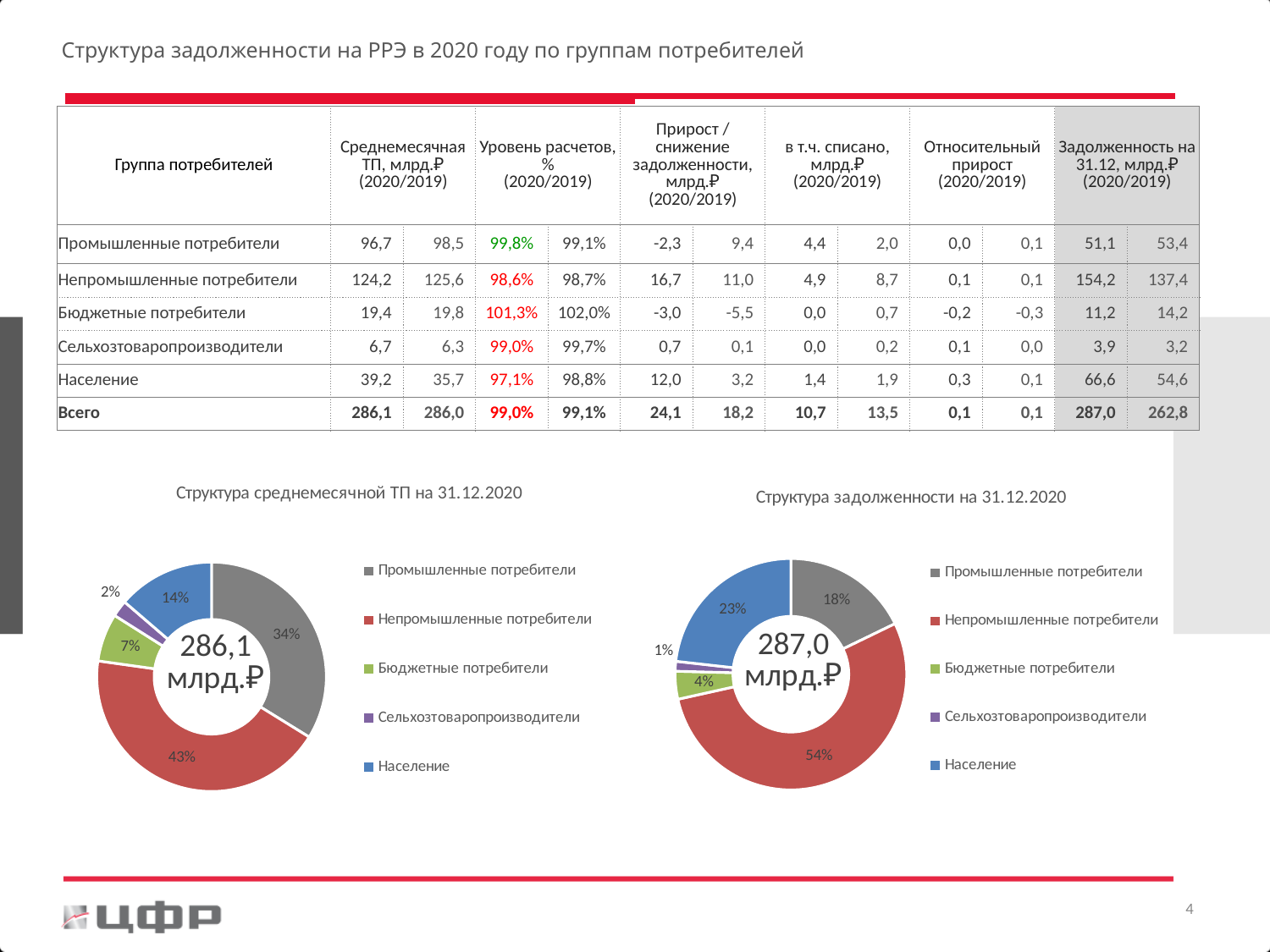
In the chart 'Структура среднемесячной ТП на 31.12.2020', what share do Промышленные потребители have? 34% In the chart 'Структура среднемесячной ТП на 31.12.2020', which colour represents Население? Blue In the chart 'Структура задолженности на 31.12.2020', which group has the largest share? Непромышленные потребители What type of chart is 'Структура среднемесячной ТП на 31.12.2020'? Pie (donut) chart In the chart 'Структура среднемесячной ТП на 31.12.2020', what total value is shown in the centre of the donut? 286,1 млрд.₽ In the chart 'Структура задолженности на 31.12.2020', what total value is shown in the centre of the donut? 287,0 млрд.₽ In the chart 'Структура среднемесячной ТП на 31.12.2020', what share do Непромышленные потребители have? 43% In the chart 'Структура задолженности на 31.12.2020', which share is larger: Бюджетные потребители or Сельхозтоваропроизводители? Бюджетные потребители In the chart 'Структура задолженности на 31.12.2020', what share does Население have? 23% How many categories does the legend of the chart 'Структура задолженности на 31.12.2020' list? 5 In the chart 'Структура задолженности на 31.12.2020', what is the difference in percentage points between Непромышленные потребители and Промышленные потребители? 36 percentage points In the chart 'Структура среднемесячной ТП на 31.12.2020', which group has the smallest share? Сельхозтоваропроизводители